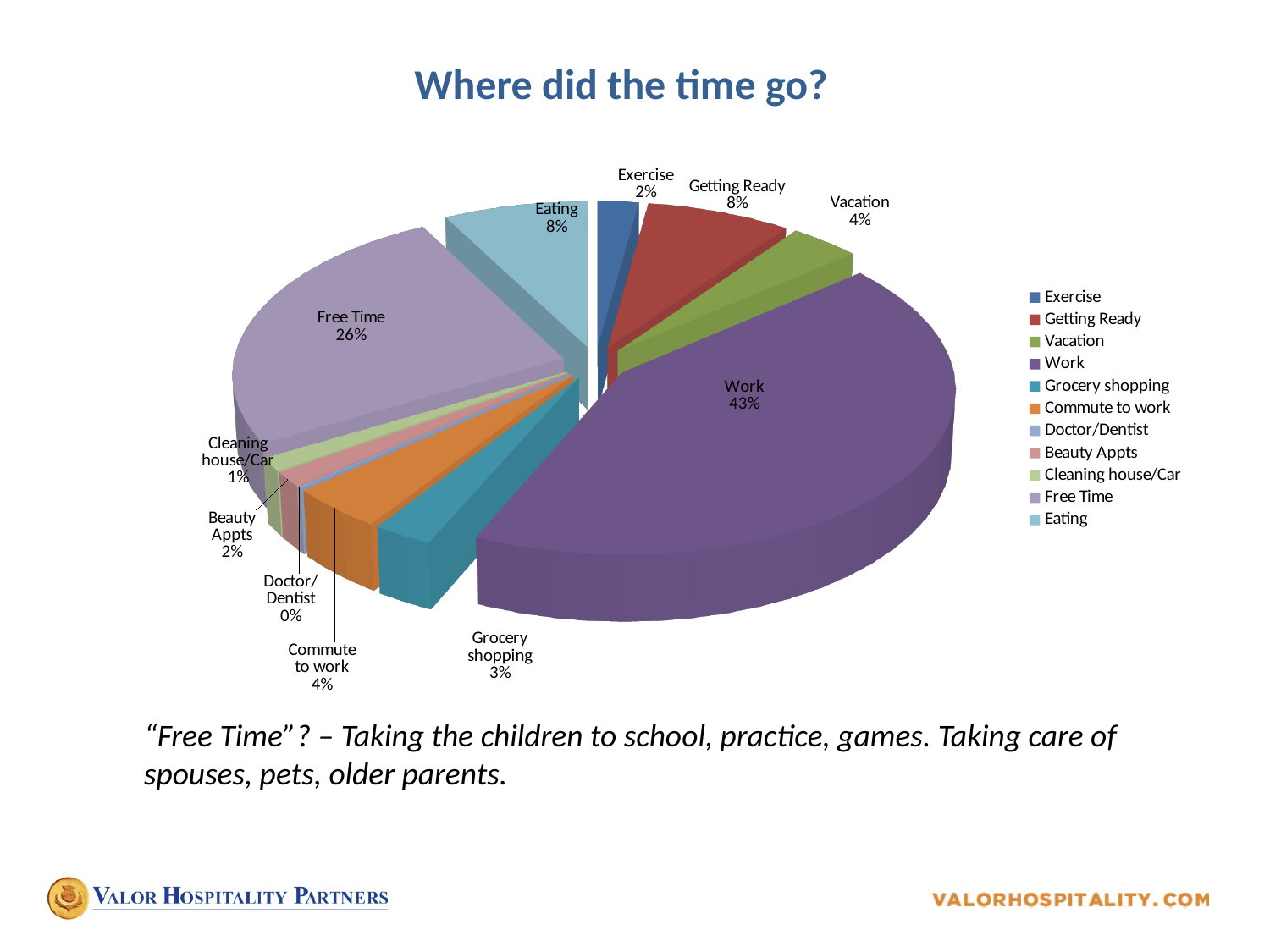
What is the difference in percentage points between Work and Free Time? 17 What kind of chart is shown on the slide? Pie chart What percentage is shown for Getting Ready? 8% Which category has the largest slice of the pie? Work Which category has the smallest slice of the pie? Doctor/Dentist What percentage is shown for Doctor/Dentist? 0% Which category is shown in the legend immediately after Work? Grocery shopping How many categories does the pie chart have? 11 What percentage is shown for Free Time? 26% What share of the pie does Work take? 43% What is the title of the slide containing the pie chart? Where did the time go? Which is larger, Commute to work or Grocery shopping? Commute to work